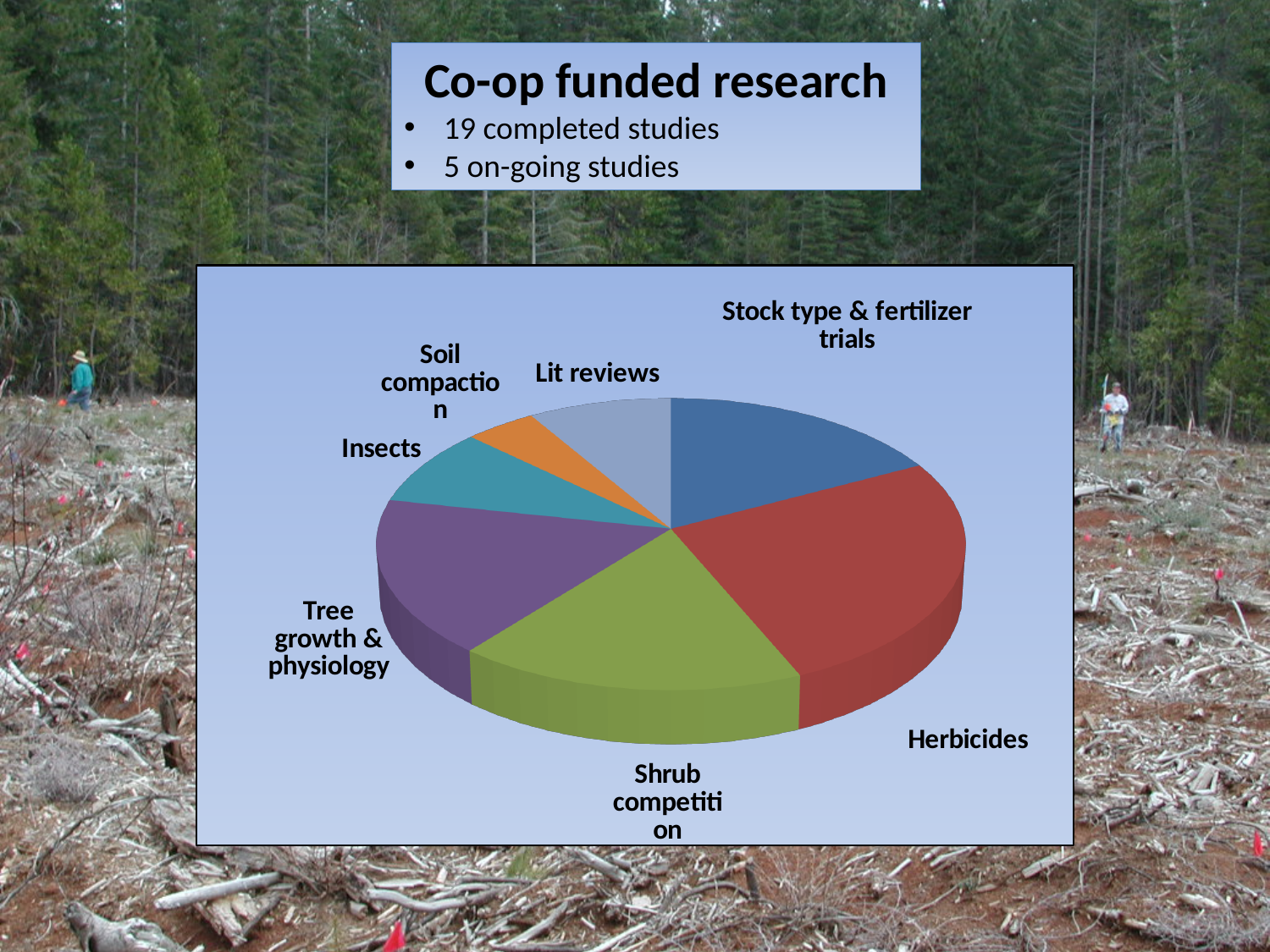
What kind of chart is shown on the slide? pie chart How many slices does the pie chart have? 7 What colour is the Shrub competition slice of the pie chart? green What colour is the Herbicides slice of the pie chart? red Which slice is larger, Stock type & fertilizer trials or Soil compaction? Stock type & fertilizer trials Which slice is larger, Tree growth & physiology or Lit reviews? Tree growth & physiology Which category has the largest slice of the pie chart? Herbicides Which slice is larger, Herbicides or Lit reviews? Herbicides Which category has the smallest slice of the pie chart? Soil compaction